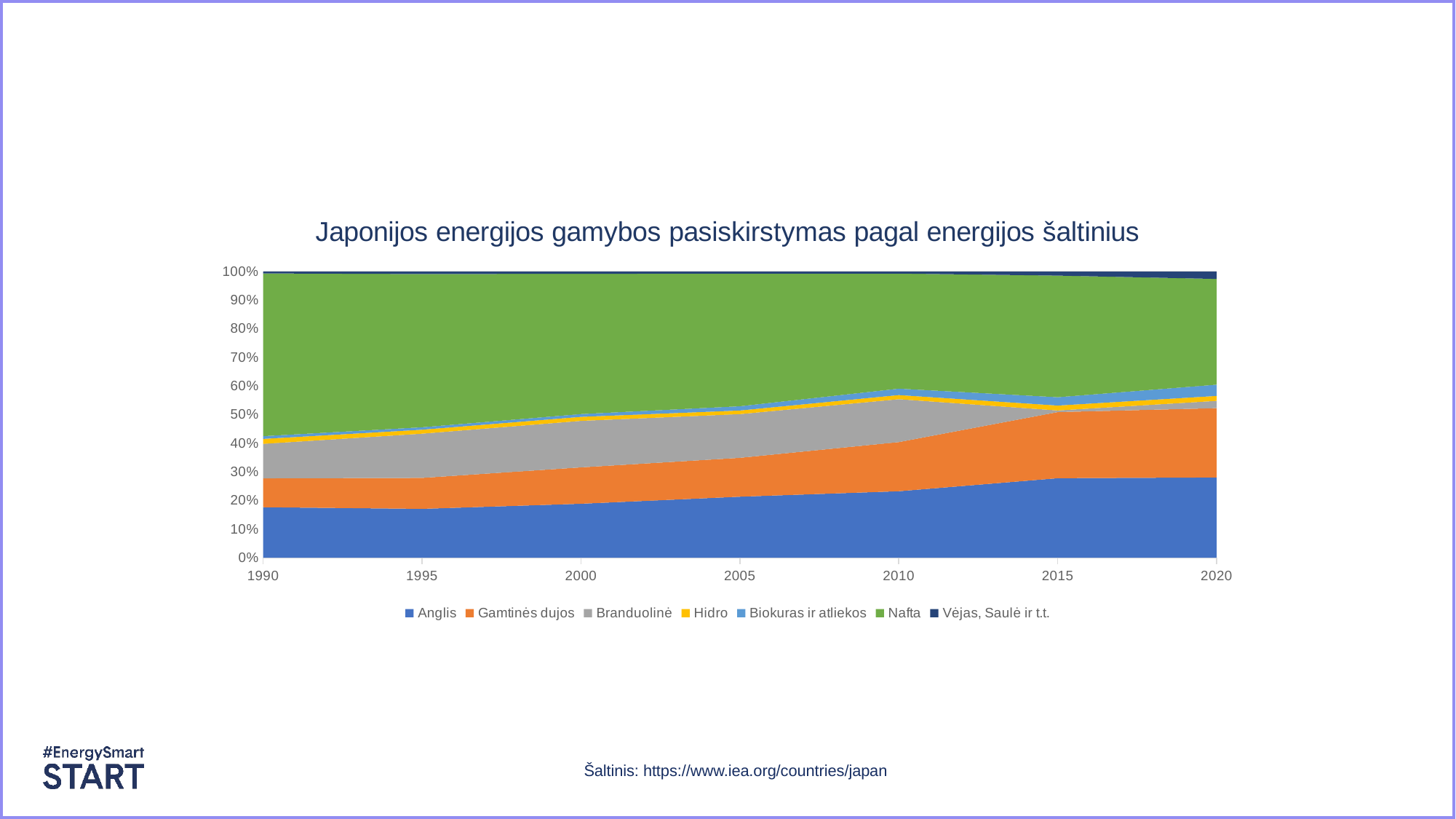
How many years are labelled on the x axis? 7 What kind of chart is shown on the slide? Stacked area chart What is the title of the chart? Japonijos energijos gamybos pasiskirstymas pagal energijos šaltinius Is the share of Anglis in 1990 greater or less than 20%? less Which series has the largest share in 1990? Nafta Is the share of Branduolinė in 2020 greater or less than 10%? less Does the share of Anglis rise or fall from 1990 to 2020? rise Is the share of Anglis in 2020 greater or less than 20%? greater How many series does the legend list? 7 Does the share of Nafta rise or fall from 1990 to 2020? fall Which series is shown in green in the legend? Nafta